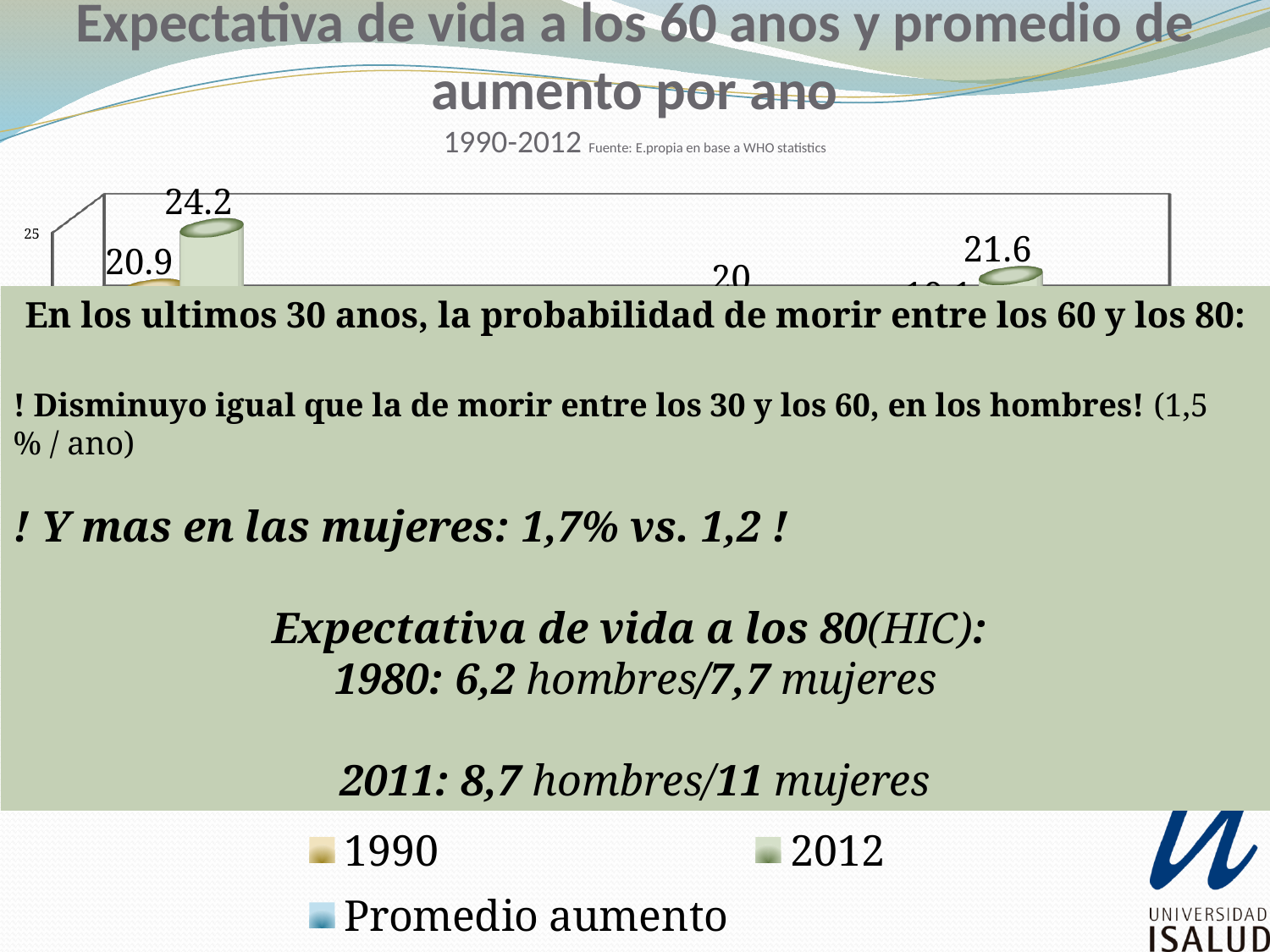
How many series does the chart legend list? 3 What is the title of the chart on the slide? Expectativa de vida a los 60 anos y promedio de aumento por ano What is the difference between the 2012 bar (24.2) and the 1990 bar (20.9) in the leftmost group? 3.3 In the leftmost group of bars, which series has the higher value, 1990 or 2012? 2012 Is the value of the bar labeled 24.2 greater or less than 25? less In the leftmost group of bars, what is the value of the 1990 (tan) bar? 20.9 What period does the chart subtitle indicate? 1990-2012 What kind of chart is shown on the slide? bar chart What is the value of the green 2012 bar shown on the right side of the chart? 21.6 In the leftmost group of bars, what is the value of the 2012 (green) bar? 24.2